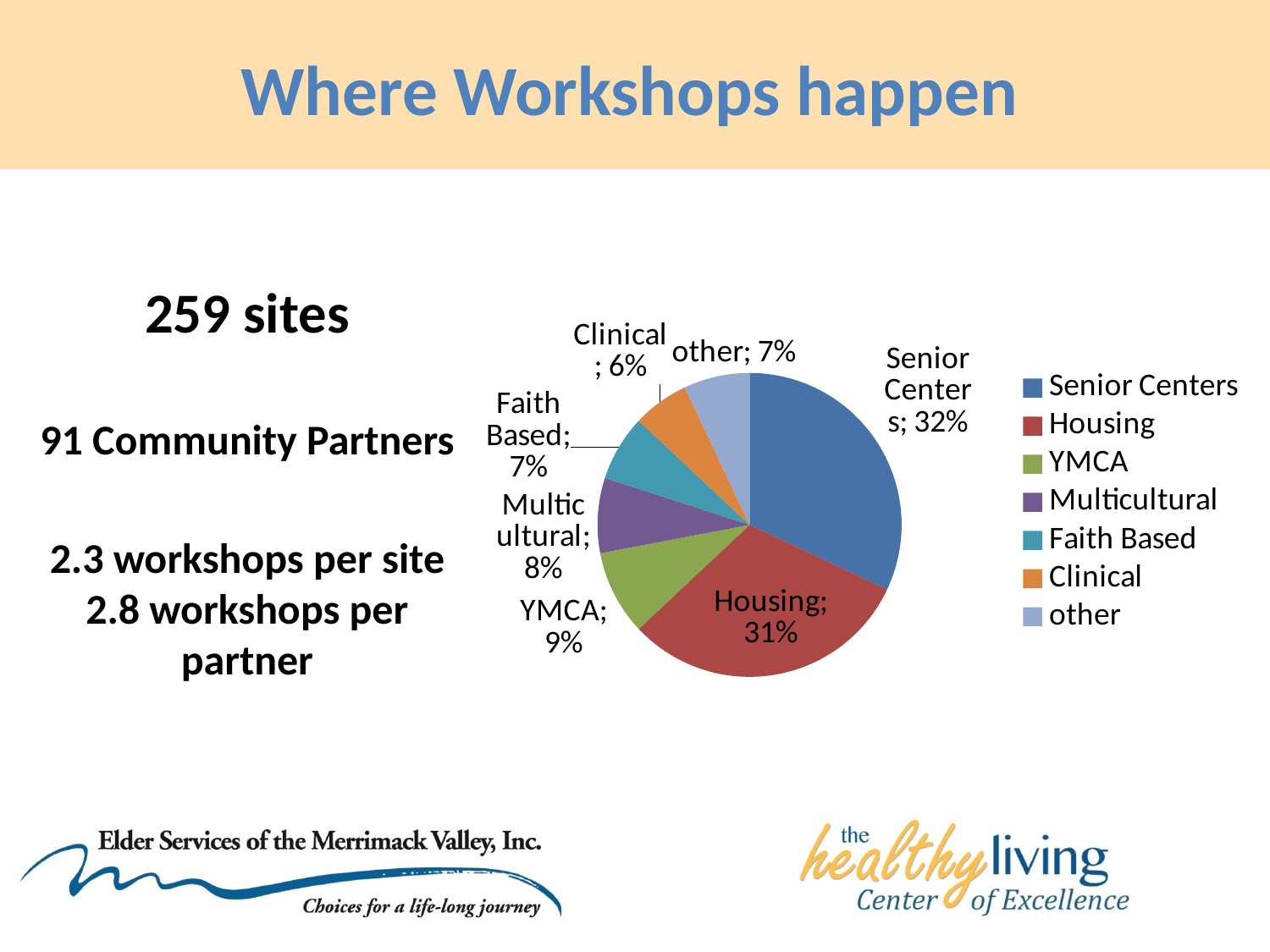
How many categories does the pie chart have? 7 What share of the pie does Clinical have? 6% What share of the pie does Senior Centers have? 32% Which category has the smallest share of the pie? Clinical What is the difference in percentage points between Senior Centers and Housing? 1 What kind of chart is shown on the slide? pie chart What share of the pie does Housing have? 31% Which category has the largest share of the pie? Senior Centers How many entries does the legend list? 7 What share of the pie does YMCA have? 9% What share of the pie does Multicultural have? 8% Which has a larger share, YMCA or Multicultural? YMCA